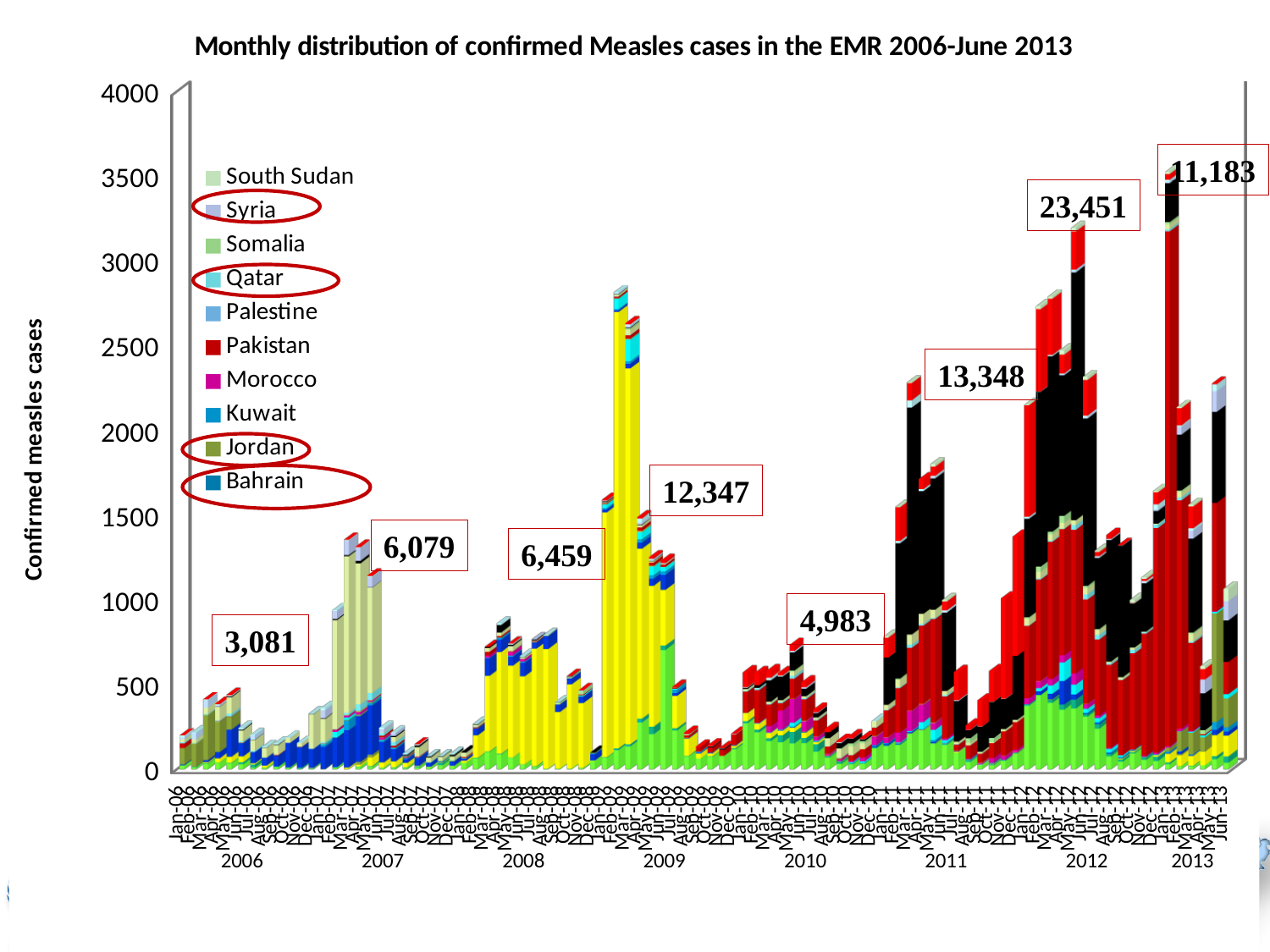
Is the value of the tallest monthly bar in 2009 greater or less than 2500? greater What annotated total of confirmed measles cases is shown for 2006? 3,081 Which year has the lowest annotated total of confirmed measles cases? 2006 What annotated total of confirmed measles cases is shown for 2012? 23,451 What is the difference between the annotated totals for 2012 and 2011? 10,103 What annotated total of confirmed measles cases is shown for 2013 (January to June)? 11,183 What is the difference between the annotated totals for 2008 and 2007? 380 Which legend entries are circled in red on the chart? Syria, Qatar, Jordan, Bahrain Which year has the larger annotated total, 2009 or 2010? 2009 Which year has the highest annotated total of confirmed measles cases? 2012 What kind of chart is shown on the slide? Stacked bar chart What is the title of the chart? Monthly distribution of confirmed Measles cases in the EMR 2006-June 2013